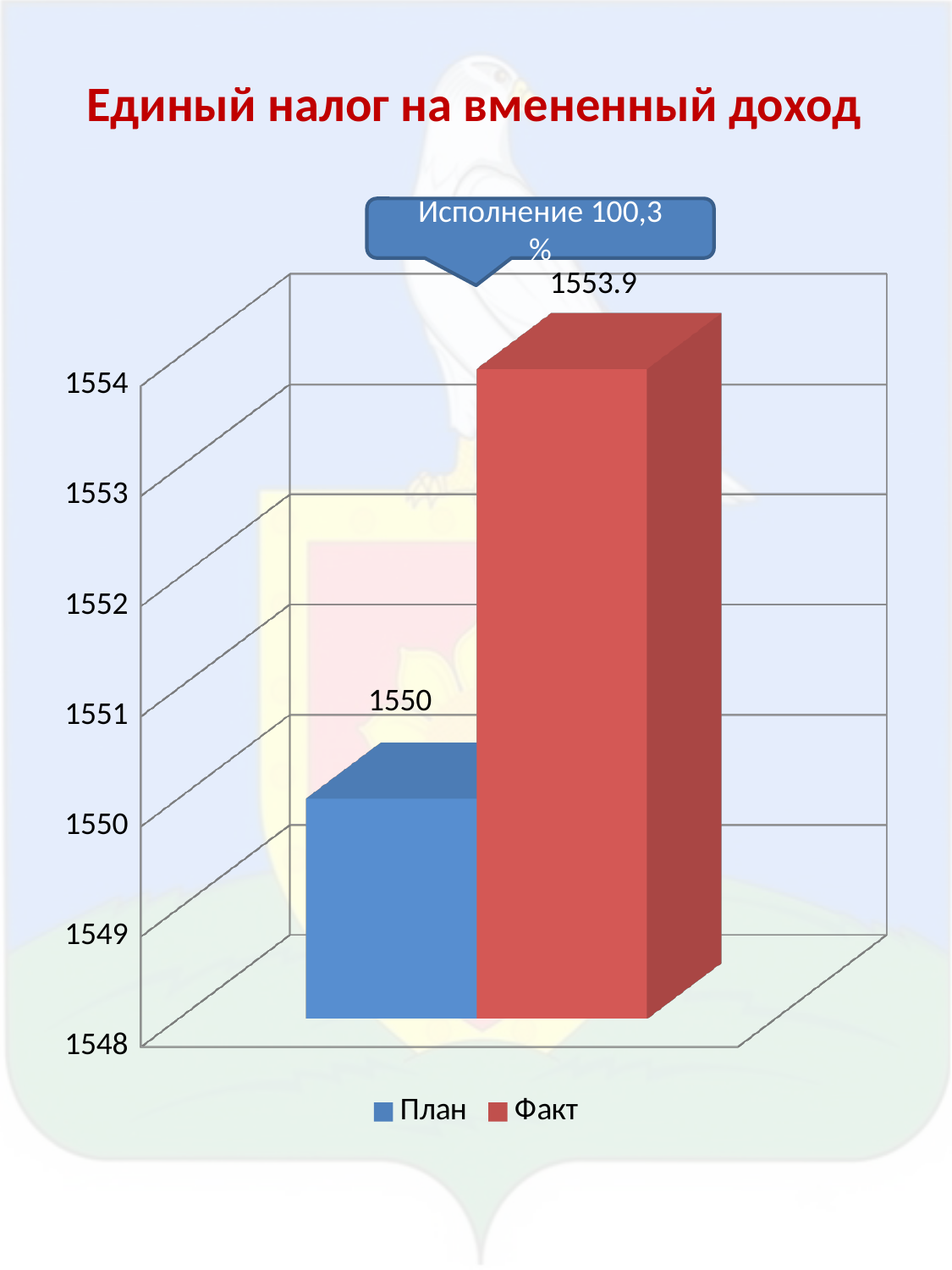
What kind of chart is shown on the slide? Bar chart What is the difference between the Факт and План values? 3.9 What is the value of Факт (Fact) on the chart? 1553.9 Which series has the higher value, План or Факт? Факт Is the value for План greater or less than 1551? less What execution percentage is shown in the callout above the chart? 100,3 % Is the value for Факт greater or less than 1552? greater What is the value of План (Plan) on the chart? 1550 How many series does the legend list? 2 What is the maximum value shown on the vertical axis? 1554 What is the title of the slide? Единый налог на вмененный доход Which series has the lowest value on the chart? План